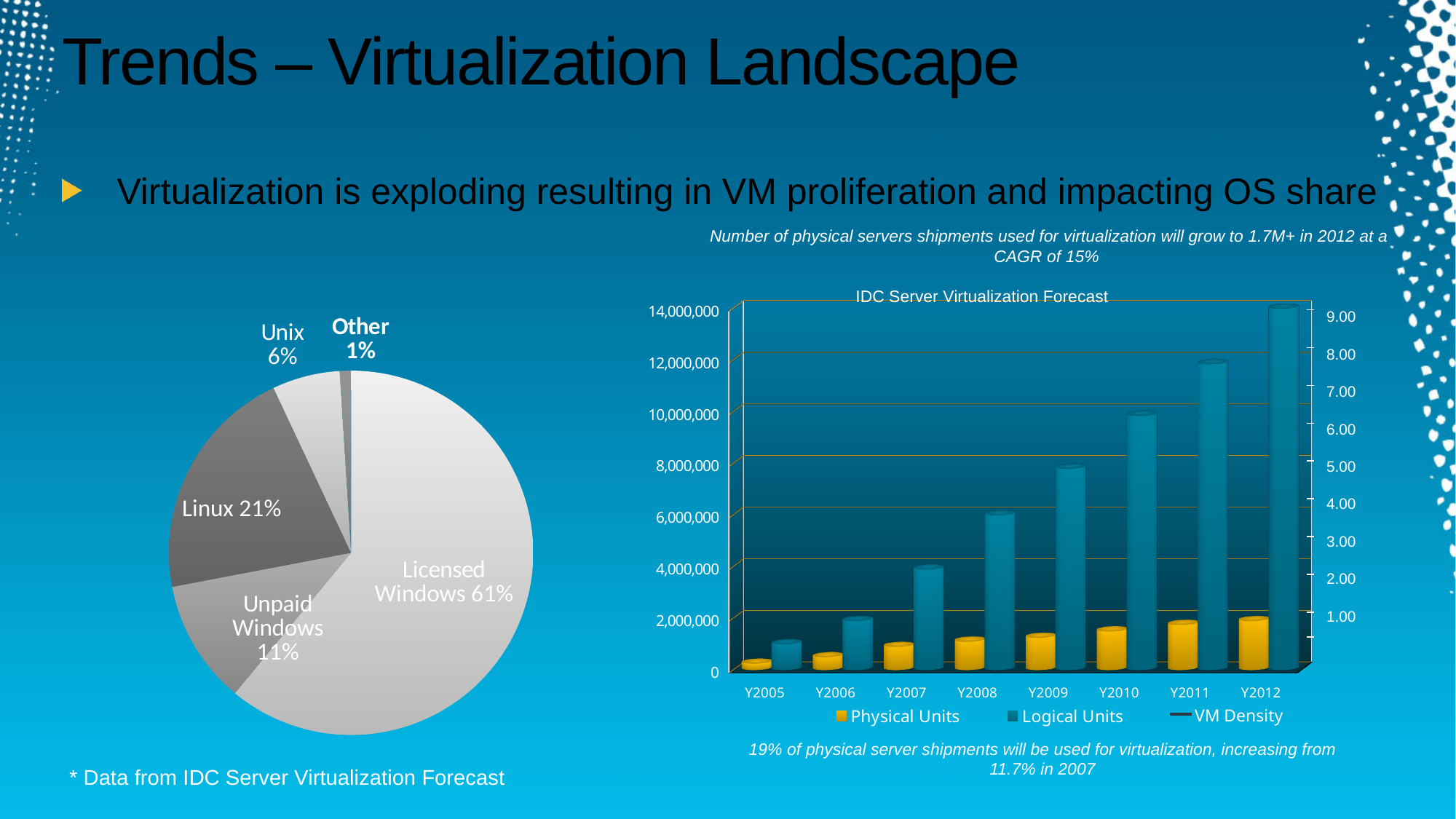
In the IDC Server Virtualization Forecast chart, is the Logical Units value for Y2012 greater or less than 12,000,000? greater On the pie chart on the left, what share does Linux have? 21% What kind of chart is the IDC Server Virtualization Forecast chart? Bar chart On the pie chart on the left, which slice is the largest? Licensed Windows On the pie chart on the left, what share does Licensed Windows have? 61% On the pie chart on the left, which is larger: Linux or Unpaid Windows? Linux How many series does the legend of the IDC Server Virtualization Forecast chart list? 3 On the pie chart on the left, which slice is the smallest? Other How many slices does the pie chart on the left have? 5 On the pie chart on the left, what is the difference in percentage points between Linux and Unix? 15% How many years are shown on the x axis of the IDC Server Virtualization Forecast chart? 8 In the IDC Server Virtualization Forecast chart, do the Logical Units values rise or fall from Y2005 to Y2012? Rise